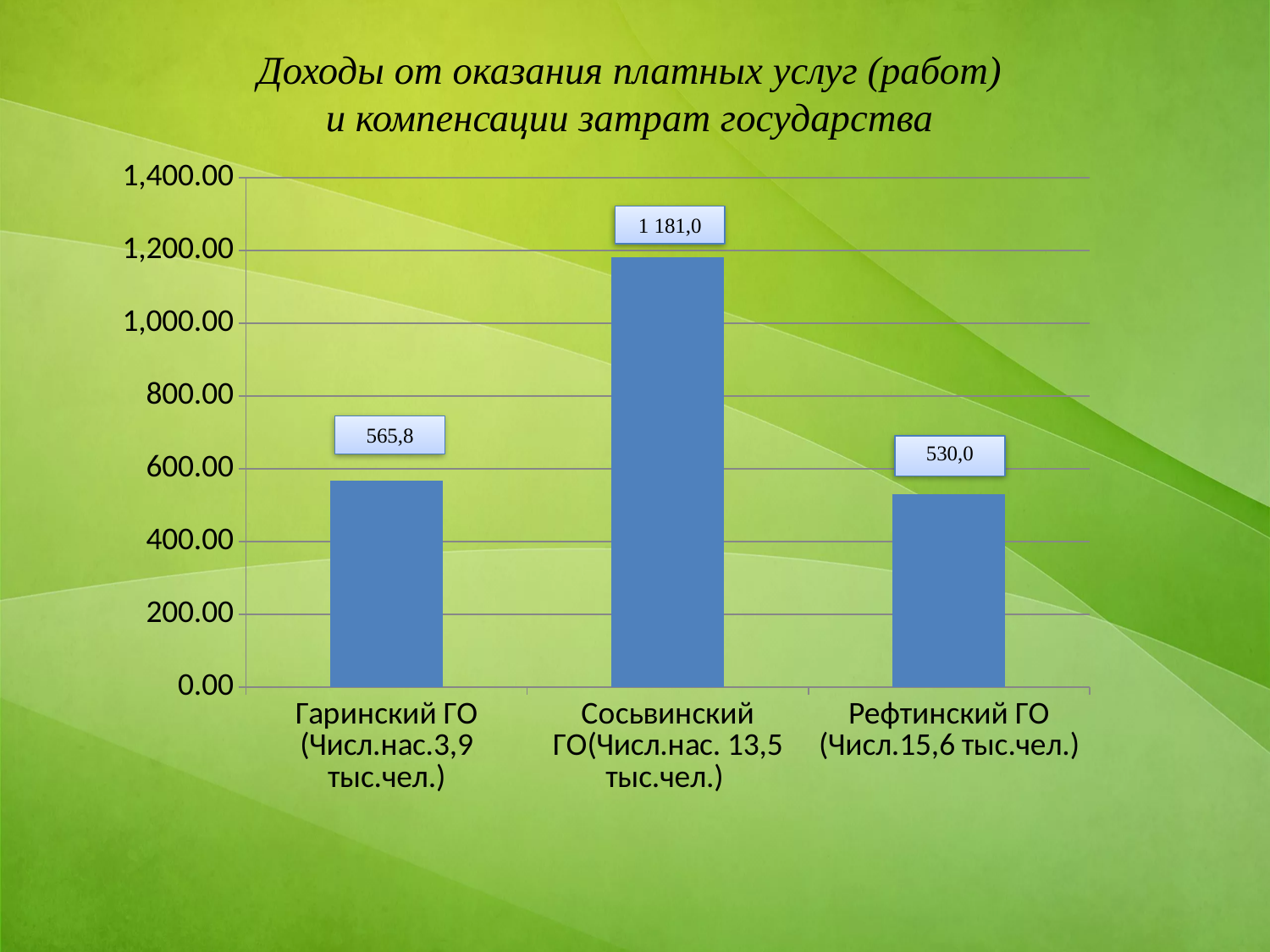
How many categories are shown on the chart? 3 What kind of chart is shown on the slide? bar chart What is the difference between the values for Сосьвинский ГО and Гаринский ГО? 615,2 What is the difference between the values for Гаринский ГО and Рефтинский ГО? 35,8 Is the value for Сосьвинский ГО greater or less than 1,000.00? greater Which category has the highest value? Сосьвинский ГО What is the value for Сосьвинский ГО? 1 181,0 What is the value for Рефтинский ГО? 530,0 Which is larger, the value for Гаринский ГО or the value for Рефтинский ГО? Гаринский ГО What is the title of the chart? Доходы от оказания платных услуг (работ) и компенсации затрат государства Which category has the lowest value? Рефтинский ГО What is the value for Гаринский ГО? 565,8